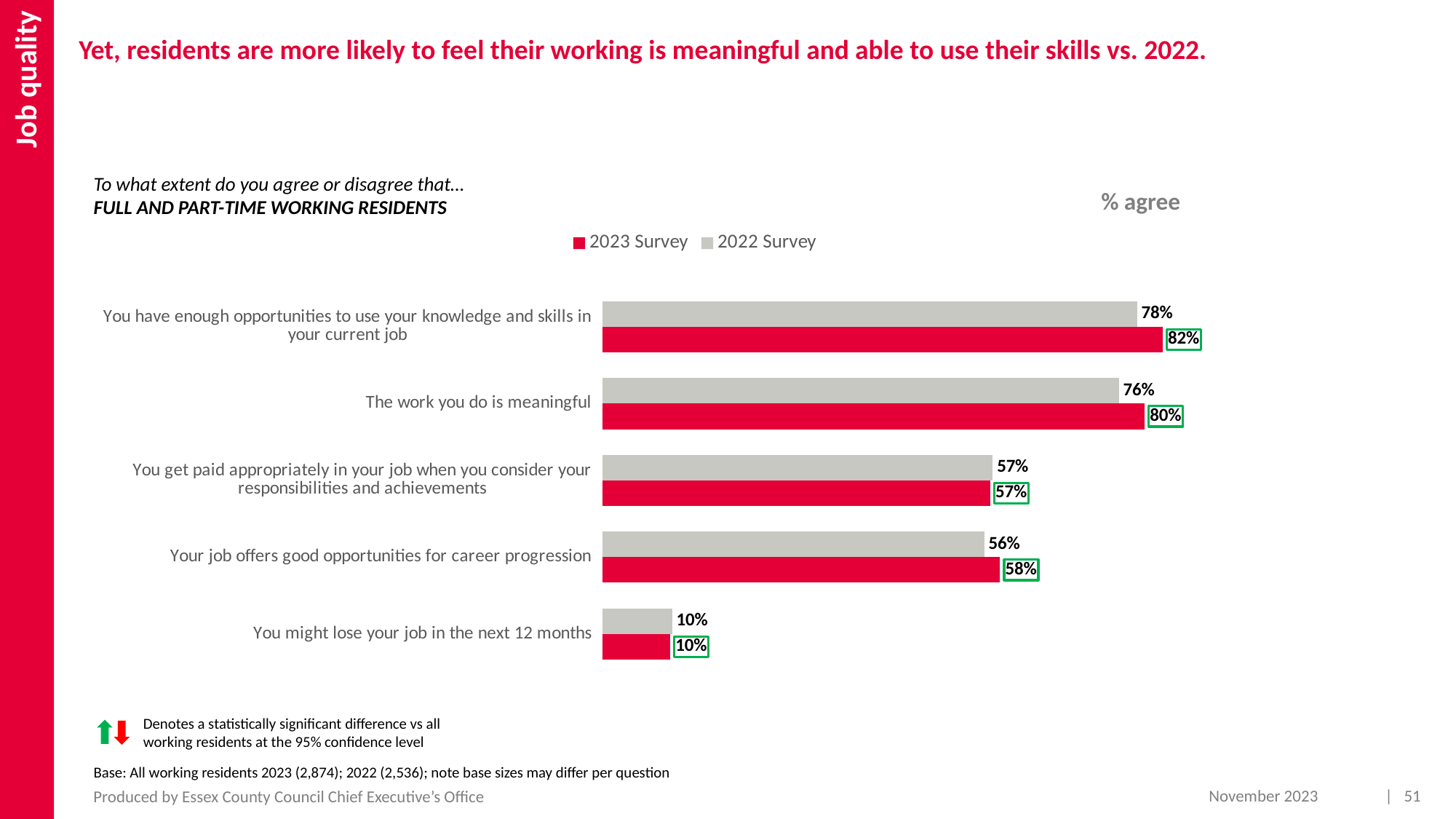
Which is larger for 'You get paid appropriately in your job when you consider your responsibilities and achievements': the 2023 Survey value or the 2022 Survey value? They are equal (57%) What is the difference between the 2023 Survey and 2022 Survey values for 'You have enough opportunities to use your knowledge and skills in your current job'? 4 percentage points How many series does the legend list? 2 What percentage agreed in the 2022 Survey that the work they do is meaningful? 76% What type of chart is shown on the slide? Bar chart How many statements are shown in the chart? 5 What percentage of residents agreed in the 2023 Survey that they have enough opportunities to use their knowledge and skills in their current job? 82% By how many percentage points did agreement that 'The work you do is meaningful' change from the 2022 Survey to the 2023 Survey? 4 percentage points Which statement has the highest 2023 Survey percentage? You have enough opportunities to use your knowledge and skills in your current job Which colour represents the 2023 Survey in the chart? Red Which statement has the lowest 2022 Survey percentage? You might lose your job in the next 12 months What is the 2023 Survey value for 'Your job offers good opportunities for career progression'? 58%